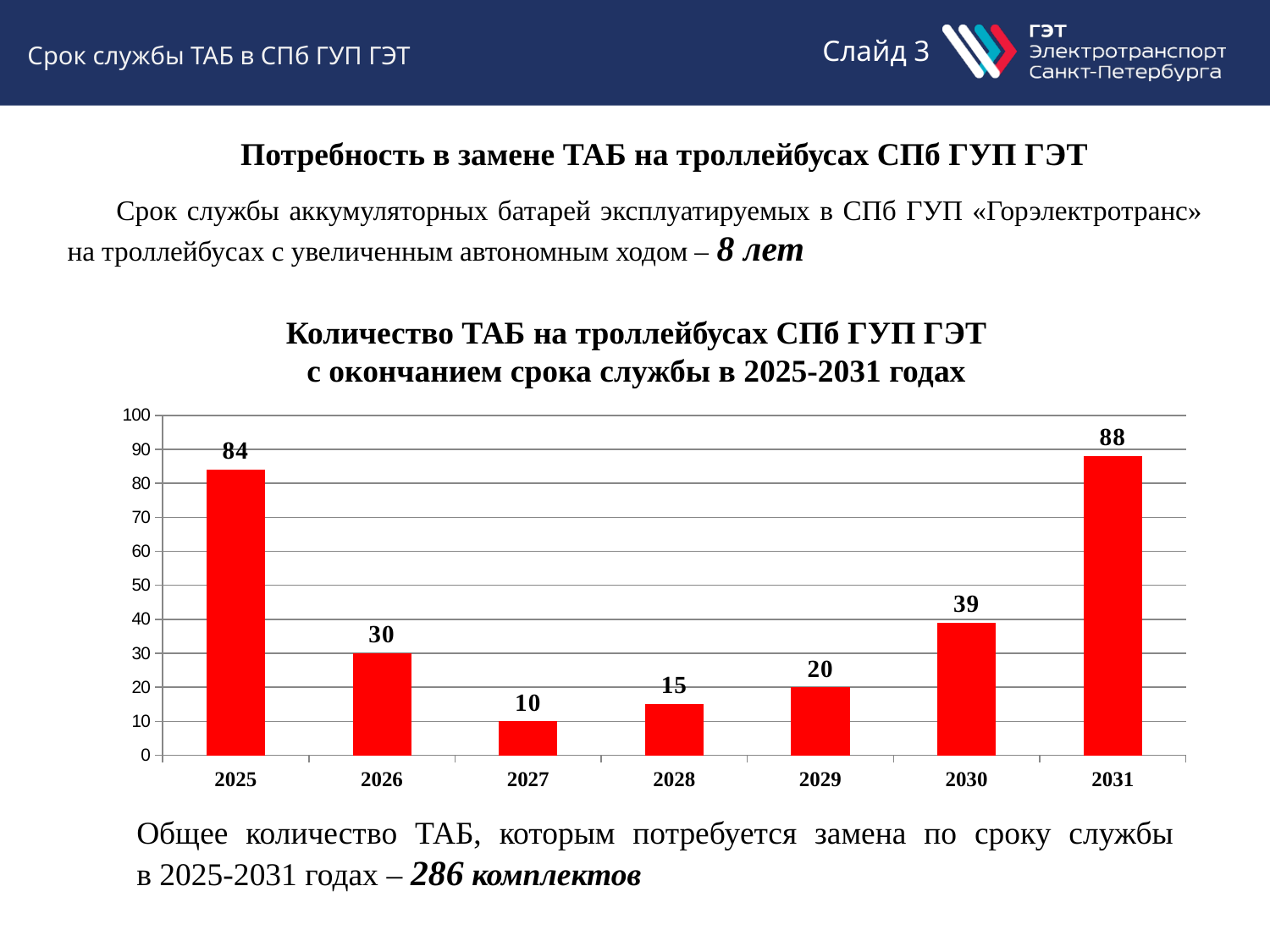
What is the value for 2030? 39 What kind of chart is shown on the slide? bar chart Which is larger, the value for 2028 or the value for 2029? 2029 What is the difference between the values for 2026 and 2027? 20 What is the difference between the values for 2031 and 2025? 4 Which year has the lowest value? 2027 Is the value for 2030 greater or less than 50? less What is the value for 2025? 84 How many years are shown on the x axis? 7 What colour are the bars in the chart? red Which year has the highest value? 2031 What is the value for 2029? 20